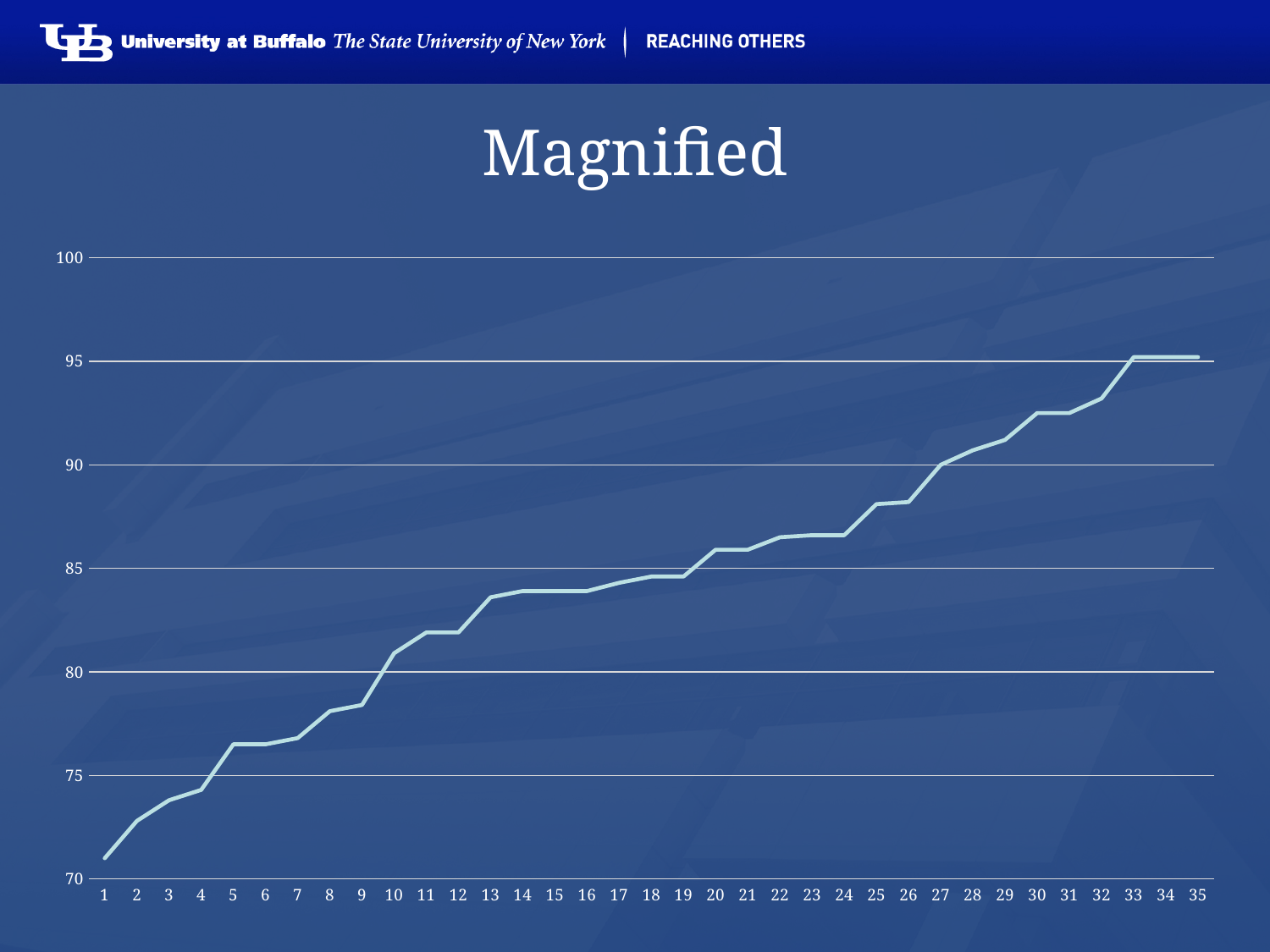
Which x-axis point has the highest value? 33, 34 and 35 (tied) What kind of chart is shown on the slide? line chart Is the value at point 25 greater or less than 85? greater Is the value at point 1 greater or less than 75? less Is the value at point 9 greater or less than 80? less What is the title of the chart? Magnified Do the values generally rise or fall from point 1 to point 35? rise Which x-axis point has the lowest value? 1 How many points are plotted along the x axis? 35 Which has the larger value, point 10 or point 20? point 20